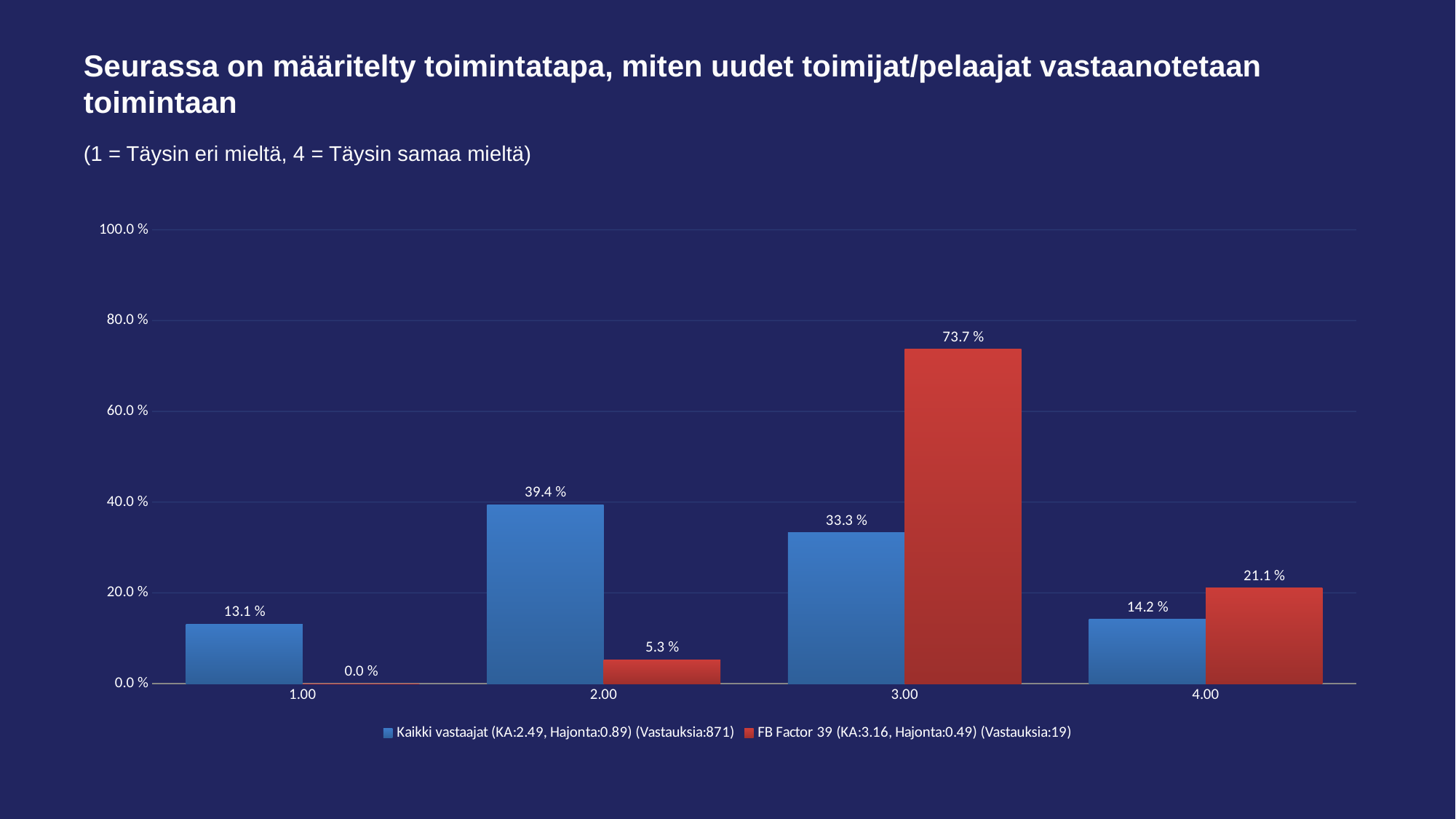
What is the value for Kaikki vastaajat at 4.00? 14.2 % What is the value for FB Factor 39 at 3.00? 73.7 % What is the value for Kaikki vastaajat at 2.00? 39.4 % What is the value for FB Factor 39 at 1.00? 0.0 % Is the value for FB Factor 39 at 4.00 greater or less than 20.0 %? greater At 2.00, which series has the larger value, Kaikki vastaajat or FB Factor 39? Kaikki vastaajat How many series does the legend list? 2 Which category has the highest value for FB Factor 39? 3.00 What kind of chart is shown on the slide? Bar chart Which category has the lowest value for Kaikki vastaajat? 1.00 How many categories are shown on the x axis? 4 What is the difference between the FB Factor 39 and Kaikki vastaajat values at 3.00? 40.4 %